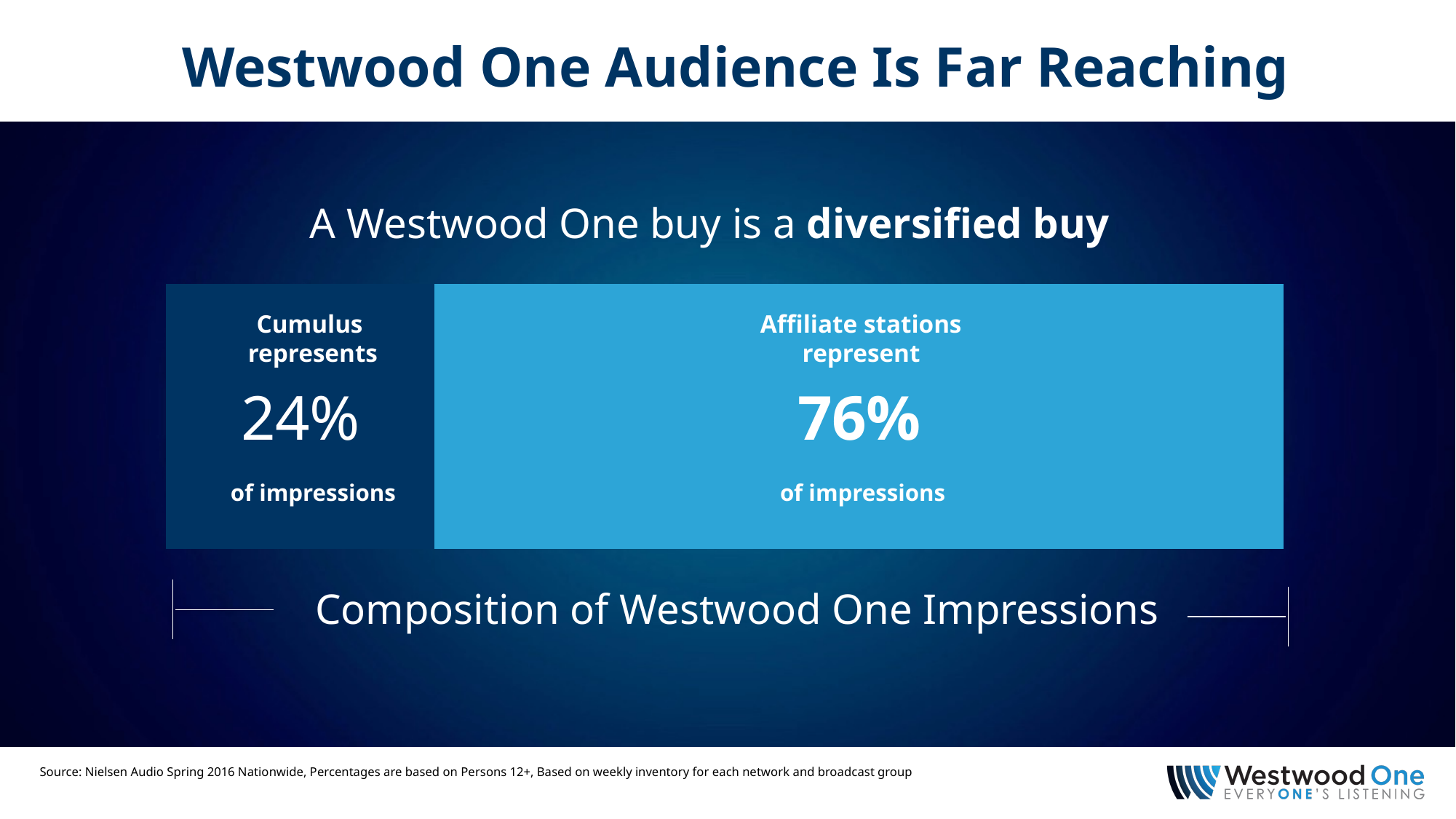
What kind of chart is used to show the composition of Westwood One impressions? Stacked bar chart What is the title shown beneath the bar? Composition of Westwood One Impressions Which segment of the bar is shown in the lighter blue colour? Affiliate stations Which group represents the smallest share of Westwood One impressions? Cumulus Which segment of the impressions bar is larger, Cumulus or affiliate stations? Affiliate stations What share of Westwood One impressions do affiliate stations represent? 76% What is the difference in percentage points between the affiliate stations' share and Cumulus's share of impressions? 52 Which group represents the largest share of Westwood One impressions? Affiliate stations What do the two segments of the impressions bar add up to? 100% How many segments make up the Composition of Westwood One Impressions bar? 2 What share of Westwood One impressions does Cumulus represent? 24%